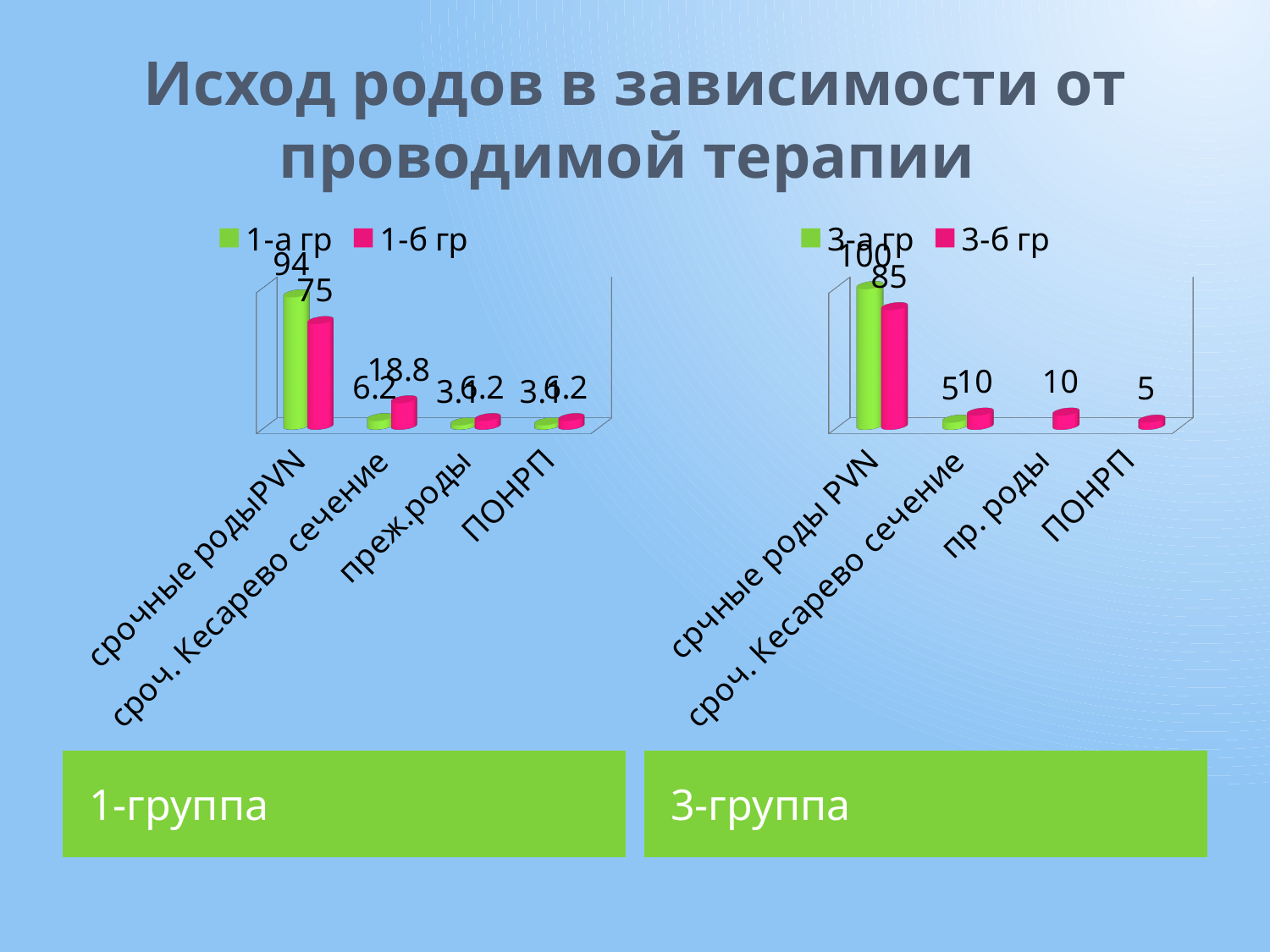
In the right chart (3-группа), what is the value for 3-б гр for ПОНРП? 5 In the left chart (1-группа), what is the value for 1-б гр for сроч. Кесарево сечение? 18.8 In the left chart (1-группа), what is the difference between the 1-а гр and 1-б гр values for срочные родыPVN? 19 In the left chart (1-группа), what is the value for 1-б гр for срочные родыPVN? 75 What kind of chart is the left chart (1-группа)? bar chart In the right chart (3-группа), what is the value for 3-б гр for срчные роды PVN? 85 In the right chart (3-группа), what is the difference between the 3-а гр and 3-б гр values for срчные роды PVN? 15 In the left chart (1-группа), what is the value for 1-а гр for срочные родыPVN? 94 How many series does the legend of the right chart (3-группа) list? 2 In the right chart (3-группа), which is larger for сроч. Кесарево сечение: 3-а гр or 3-б гр? 3-б гр In the right chart (3-группа), what is the value for 3-а гр for срчные роды PVN? 100 In the left chart (1-группа), which category has the highest value for 1-а гр? срочные родыPVN